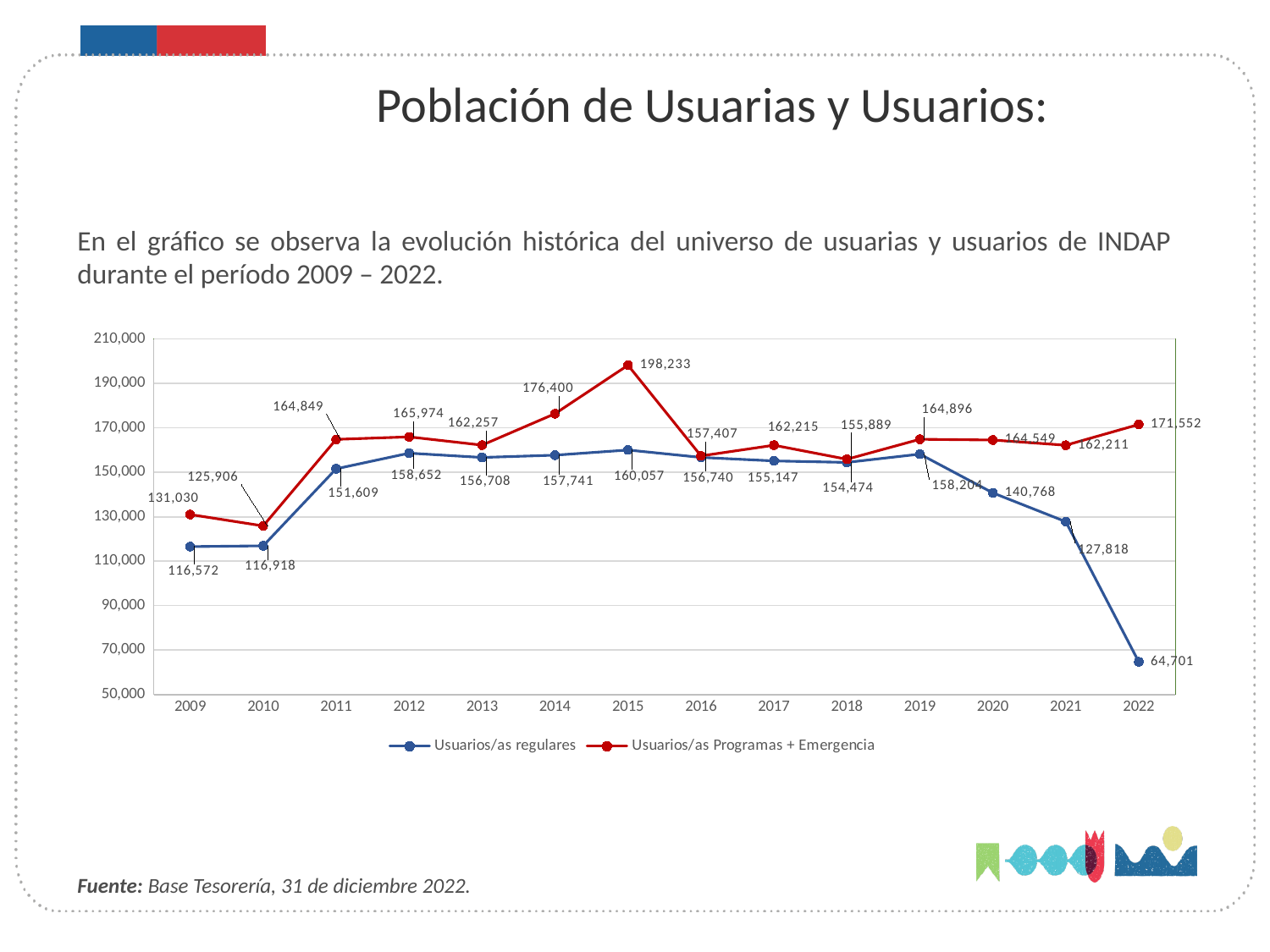
Which series has the larger value in 2014, Usuarios/as regulares or Usuarios/as Programas + Emergencia? Usuarios/as Programas + Emergencia How many years are plotted along the x axis? 14 What colour is the line for Usuarios/as Programas + Emergencia? red Does the Usuarios/as regulares series rise or fall between 2019 and 2022? fall In which year does the Usuarios/as Programas + Emergencia series reach its highest value? 2015 What is the value for Usuarios/as regulares in 2009? 116,572 What type of chart is shown on the slide? line chart What is the value for Usuarios/as regulares in 2022? 64,701 What is the value for Usuarios/as Programas + Emergencia in 2015? 198,233 In which year does the Usuarios/as regulares series reach its lowest value? 2022 How many series does the legend list? 2 What is the difference between Usuarios/as Programas + Emergencia and Usuarios/as regulares in 2022? 106,851